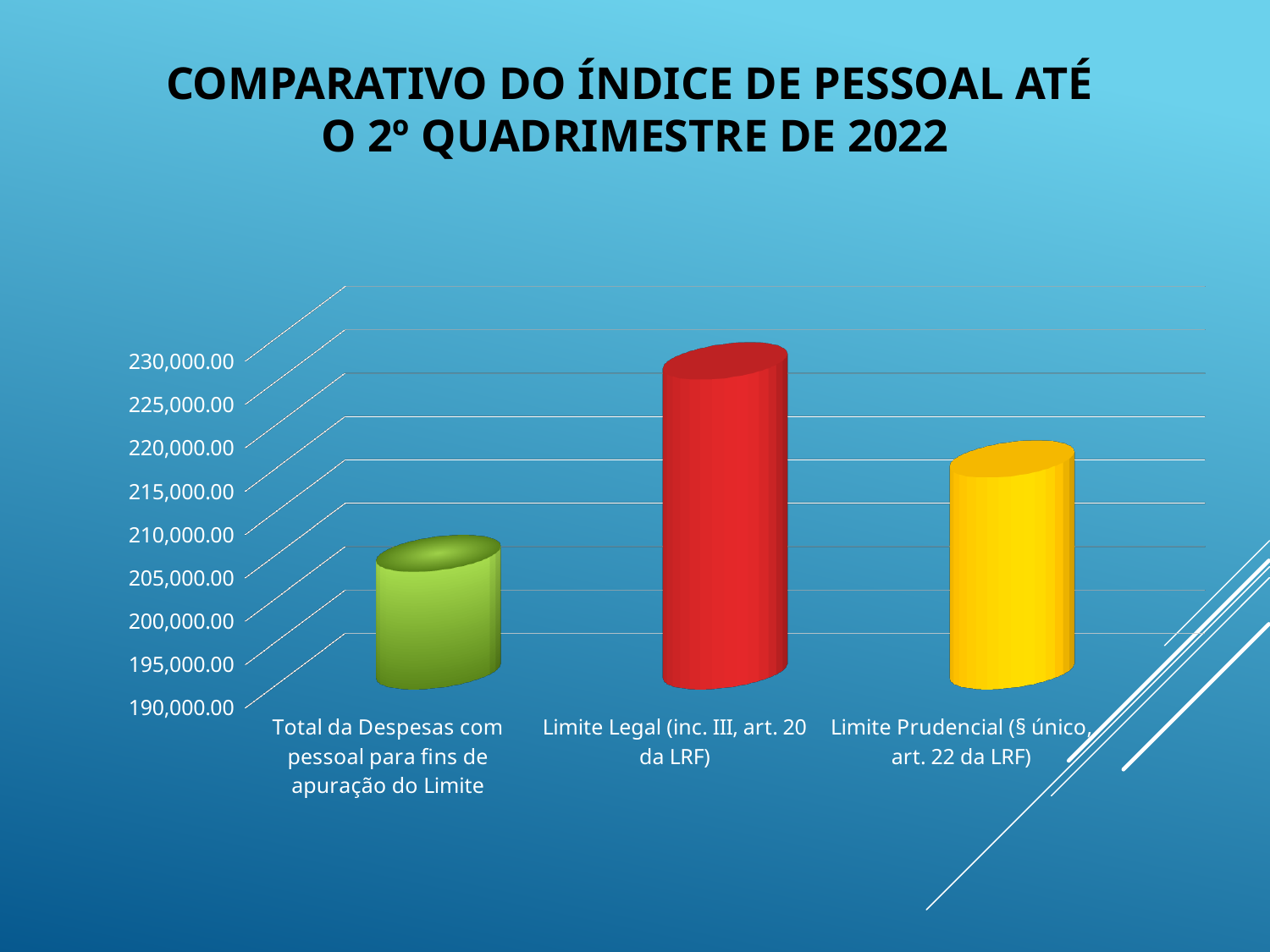
Which is larger: the value for Limite Legal (inc. III, art. 20 da LRF) or the value for Limite Prudencial (§ único, art. 22 da LRF)? Limite Legal (inc. III, art. 20 da LRF) Is the value for Total da Despesas com pessoal para fins de apuração do Limite greater or less than 215,000.00? less How many categories are plotted in the chart? 3 What is the title of the slide containing the chart? COMPARATIVO DO ÍNDICE DE PESSOAL ATÉ O 2º QUADRIMESTRE DE 2022 Is the value for Limite Prudencial (§ único, art. 22 da LRF) greater or less than 210,000.00? greater What colour is the bar for Limite Legal (inc. III, art. 20 da LRF)? red Which is larger: the value for Total da Despesas com pessoal para fins de apuração do Limite or the value for Limite Prudencial (§ único, art. 22 da LRF)? Limite Prudencial (§ único, art. 22 da LRF) Which category has the highest value? Limite Legal (inc. III, art. 20 da LRF) Is the value for Total da Despesas com pessoal para fins de apuração do Limite greater or less than 200,000.00? greater Which category has the lowest value? Total da Despesas com pessoal para fins de apuração do Limite What kind of chart is shown on the slide? bar chart